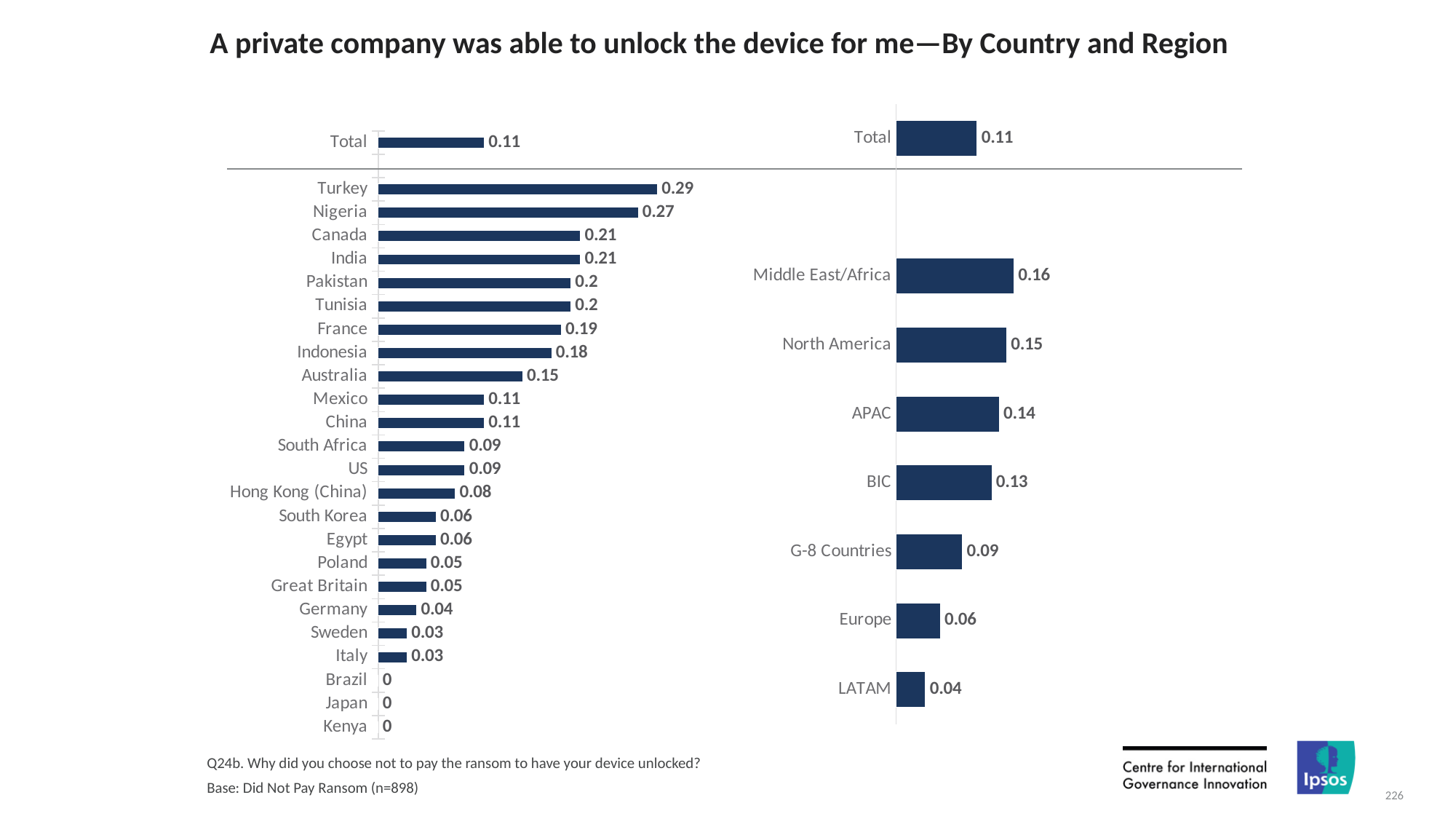
In the left chart (by country), how many countries have a value of 0? 3 In the right chart (by region), how many regions are shown below the Total bar? 7 What kind of chart is the left chart (by country)? Bar chart In the left chart (by country), what is the value for Indonesia? 0.18 What is the Total value shown on the slide? 0.11 In the right chart (by region), what is the value for Middle East/Africa? 0.16 In the left chart (by country), what is the value for Turkey? 0.29 In the left chart (by country), which country has the highest value? Turkey In the right chart (by region), which region has the lowest value? LATAM In the right chart (by region), what is the difference between the values for North America and G-8 Countries? 0.06 In the left chart (by country), what is the difference between the values for Turkey and Nigeria? 0.02 In the right chart (by region), which is larger, the value for APAC or the value for Europe? APAC